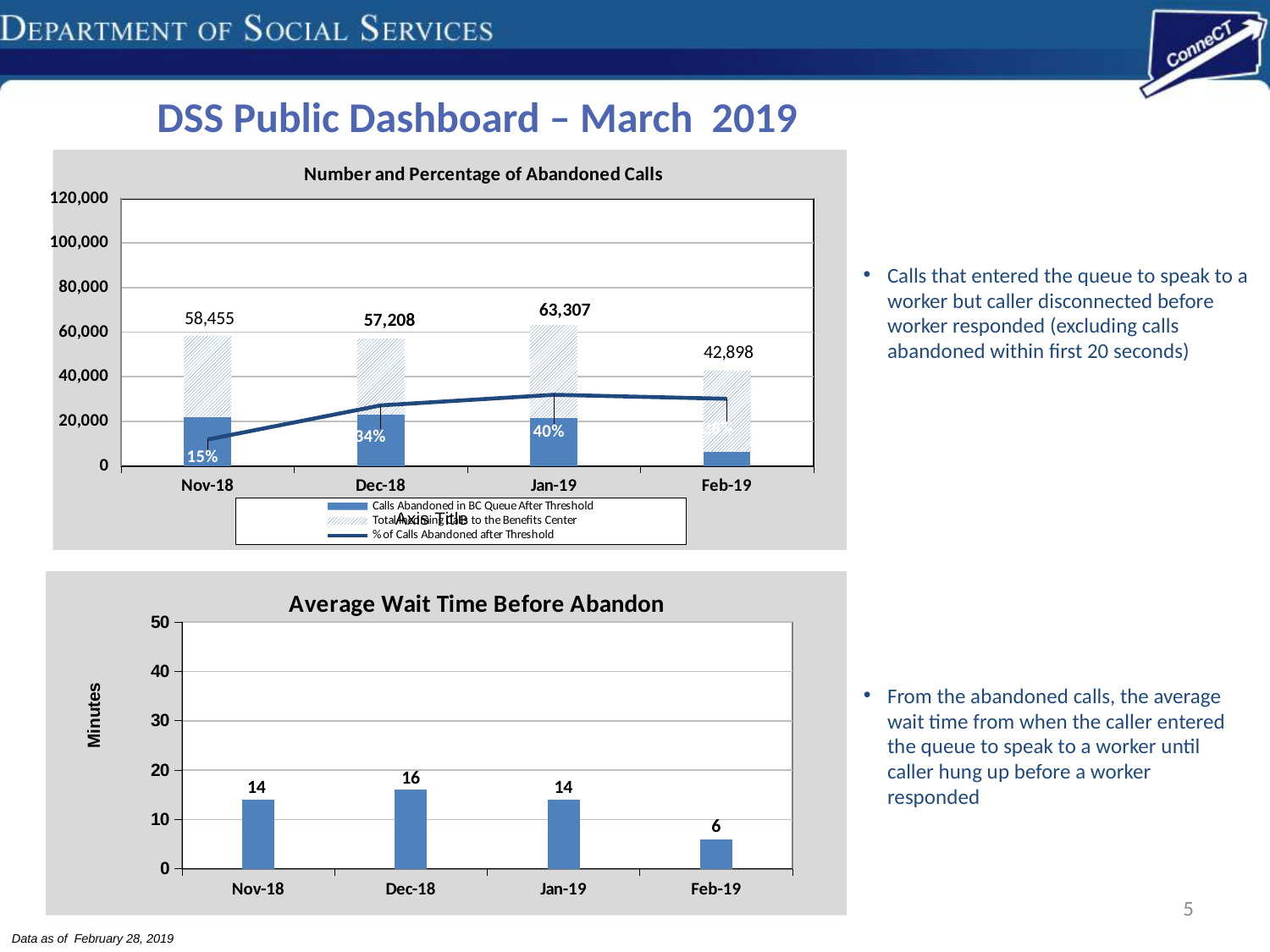
In the 'Number and Percentage of Abandoned Calls' chart, is the total incoming calls value for Nov-18 greater or less than 40,000? greater In the 'Number and Percentage of Abandoned Calls' chart, what is the total incoming calls value for Feb-19? 42,898 In the 'Number and Percentage of Abandoned Calls' chart, what is the difference between the total incoming calls for Jan-19 and Feb-19? 20,409 In the 'Number and Percentage of Abandoned Calls' chart, what is the % of calls abandoned after threshold for Nov-18? 15% How many series does the legend of the 'Number and Percentage of Abandoned Calls' chart list? 3 In the 'Average Wait Time Before Abandon' chart, what is the difference between the values for Dec-18 and Feb-19? 10 In the 'Number and Percentage of Abandoned Calls' chart, which month has the highest total incoming calls? Jan-19 In the 'Average Wait Time Before Abandon' chart, what is the value for Dec-18? 16 In the 'Number and Percentage of Abandoned Calls' chart, what is the total incoming calls value for Jan-19? 63,307 What kind of chart is the 'Average Wait Time Before Abandon' chart? bar chart In the 'Average Wait Time Before Abandon' chart, which month has the lowest average wait time? Feb-19 In the 'Number and Percentage of Abandoned Calls' chart, which month has the lowest total incoming calls? Feb-19